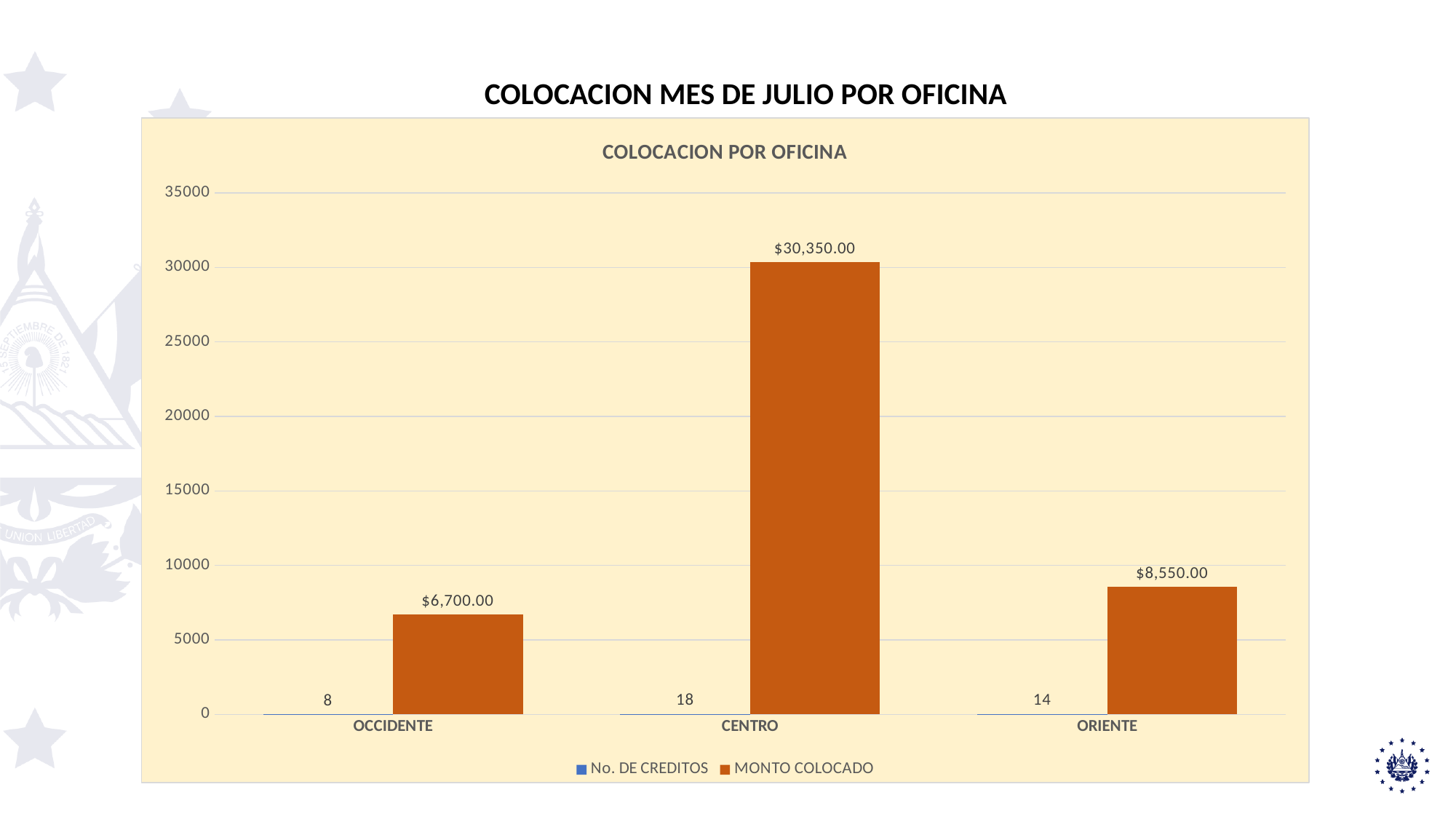
What is the No. DE CREDITOS value for ORIENTE? 14 How many offices are shown on the x axis? 3 Which office has the highest MONTO COLOCADO? CENTRO Which office has the lowest No. DE CREDITOS? OCCIDENTE What is the MONTO COLOCADO value for OCCIDENTE? $6,700.00 What is the difference in MONTO COLOCADO between CENTRO and ORIENTE? $21,800.00 What is the title shown inside the chart area? COLOCACION POR OFICINA Is the MONTO COLOCADO for CENTRO greater or less than 25000? greater What is the MONTO COLOCADO value for CENTRO? $30,350.00 Which has a larger MONTO COLOCADO, OCCIDENTE or ORIENTE? ORIENTE How many series does the legend list? 2 What kind of chart is shown? bar chart